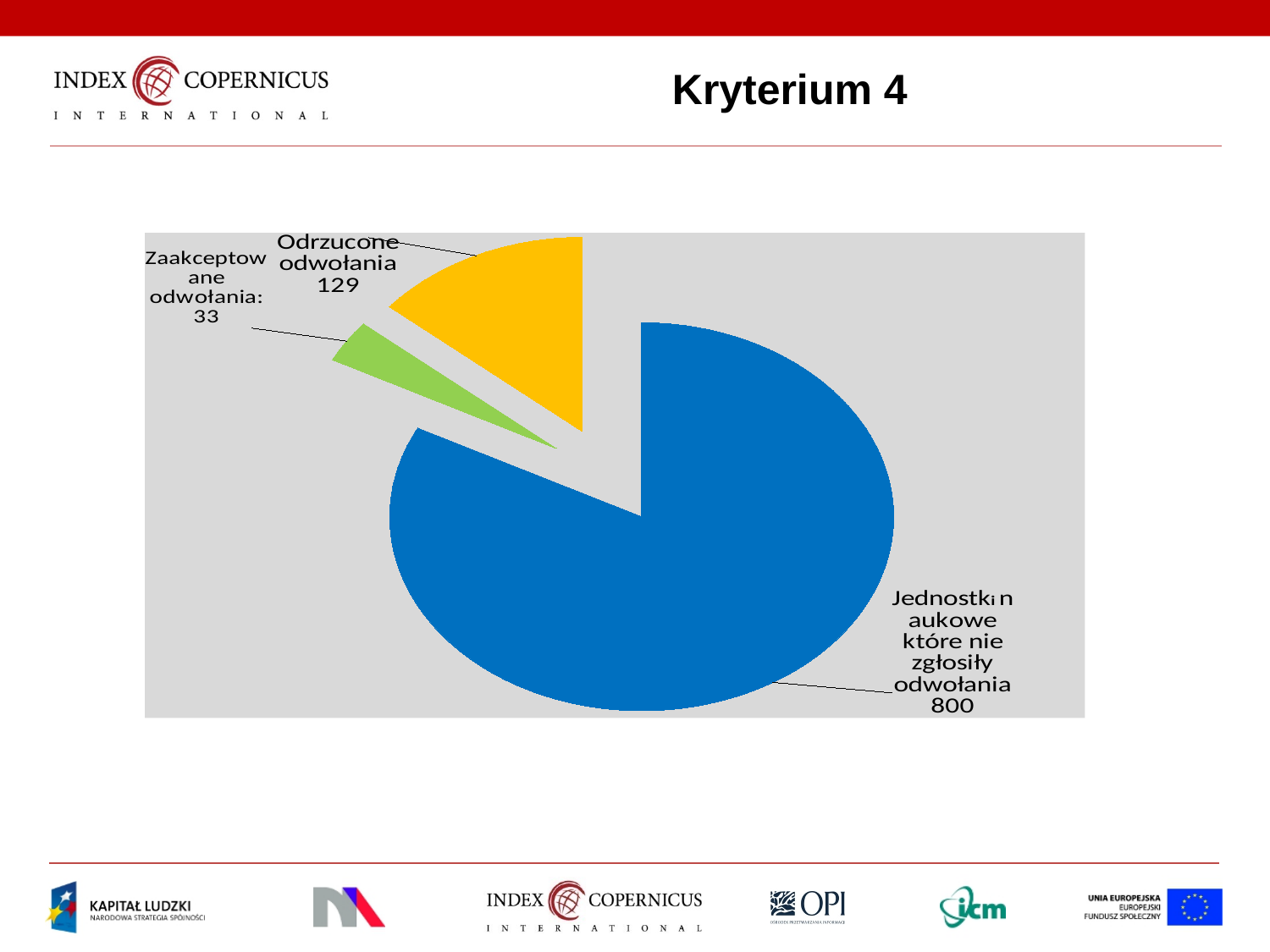
How many slices does the pie chart have? 3 What is the total of all three slices in the pie chart? 962 What is the value for "Jednostki naukowe które nie zgłosiły odwołania"? 800 What type of chart is shown on the slide? pie chart Which is larger: "Odrzucone odwołania" or "Zaakceptowane odwołania"? Odrzucone odwołania What is the value for "Odrzucone odwołania"? 129 What is the difference between the number of rejected appeals (Odrzucone odwołania) and accepted appeals (Zaakceptowane odwołania)? 96 What is the difference between the value for "Jednostki naukowe które nie zgłosiły odwołania" and "Odrzucone odwołania"? 671 What is the value for "Zaakceptowane odwołania"? 33 Which category has the largest slice of the pie? Jednostki naukowe które nie zgłosiły odwołania Which category has the smallest slice of the pie? Zaakceptowane odwołania What colour is the slice for "Zaakceptowane odwołania"? green